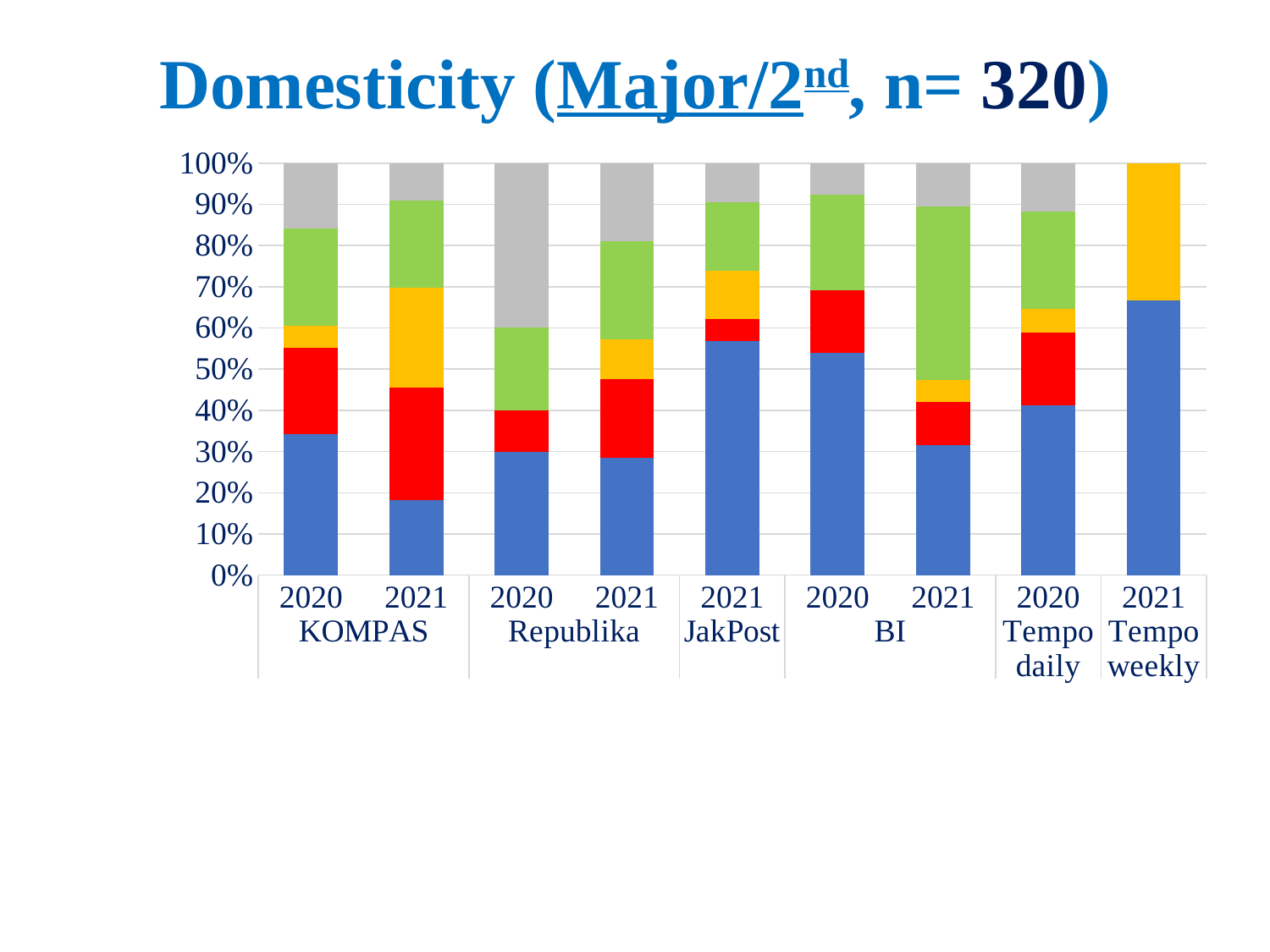
Is the blue segment for Republika 2020 greater or less than 40%? less What kind of chart is shown on the slide? Stacked bar chart How many stacked bars are plotted in the chart? 9 Which has the larger blue segment, BI 2020 or BI 2021? BI 2020 Which bar has the largest blue (bottom) segment? Tempo weekly 2021 Is the blue segment for KOMPAS 2021 greater or less than 20%? less Which has the larger blue segment, KOMPAS 2020 or KOMPAS 2021? KOMPAS 2020 What is the title of the chart on the slide? Domesticity (Major/2nd, n= 320) Which bar has the smallest blue (bottom) segment? KOMPAS 2021 How many different colours (segments) are used in the stacked bars? 5 Is the blue segment for Tempo weekly 2021 greater or less than 60%? greater